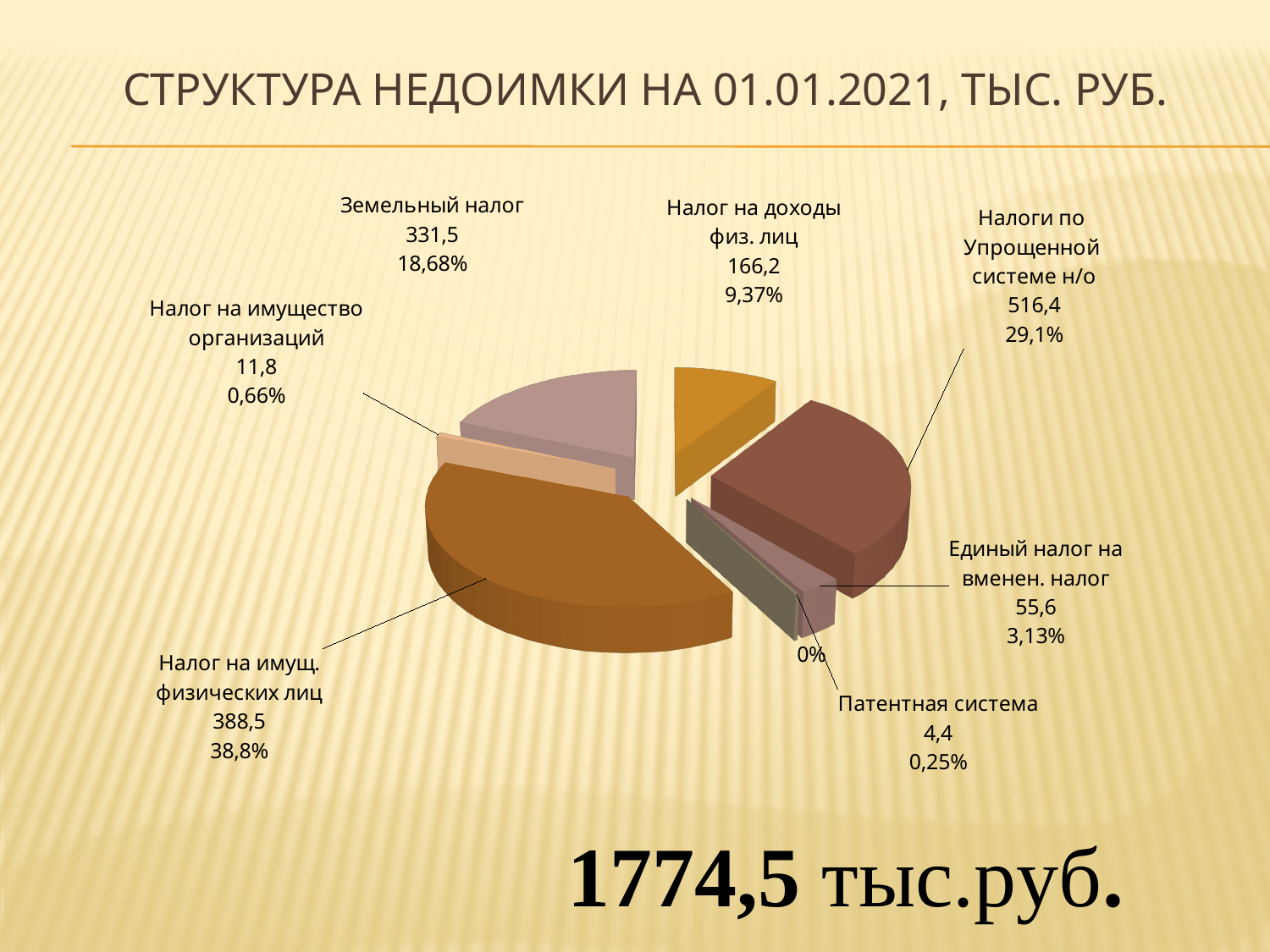
What percentage share does Налог на имущество организаций have? 0,66% What kind of chart is shown on the slide? Pie chart Which is larger: Земельный налог or Налог на доходы физ. лиц? Земельный налог Which category has the largest value in the pie chart? Налог на имущ. физических лиц What total amount is shown on the slide for the недоимка? 1774,5 тыс.руб. Which named category has the smallest value in the pie chart? Патентная система What is the value shown for Земельный налог? 331,5 What is the title of the slide? СТРУКТУРА НЕДОИМКИ НА 01.01.2021, ТЫС. РУБ. What percentage share does Налоги по Упрощенной системе н/о have? 29,1% What is the difference between the values for Земельный налог and Налог на доходы физ. лиц? 165,3 What is the value shown for Единый налог на вменен. налог? 55,6